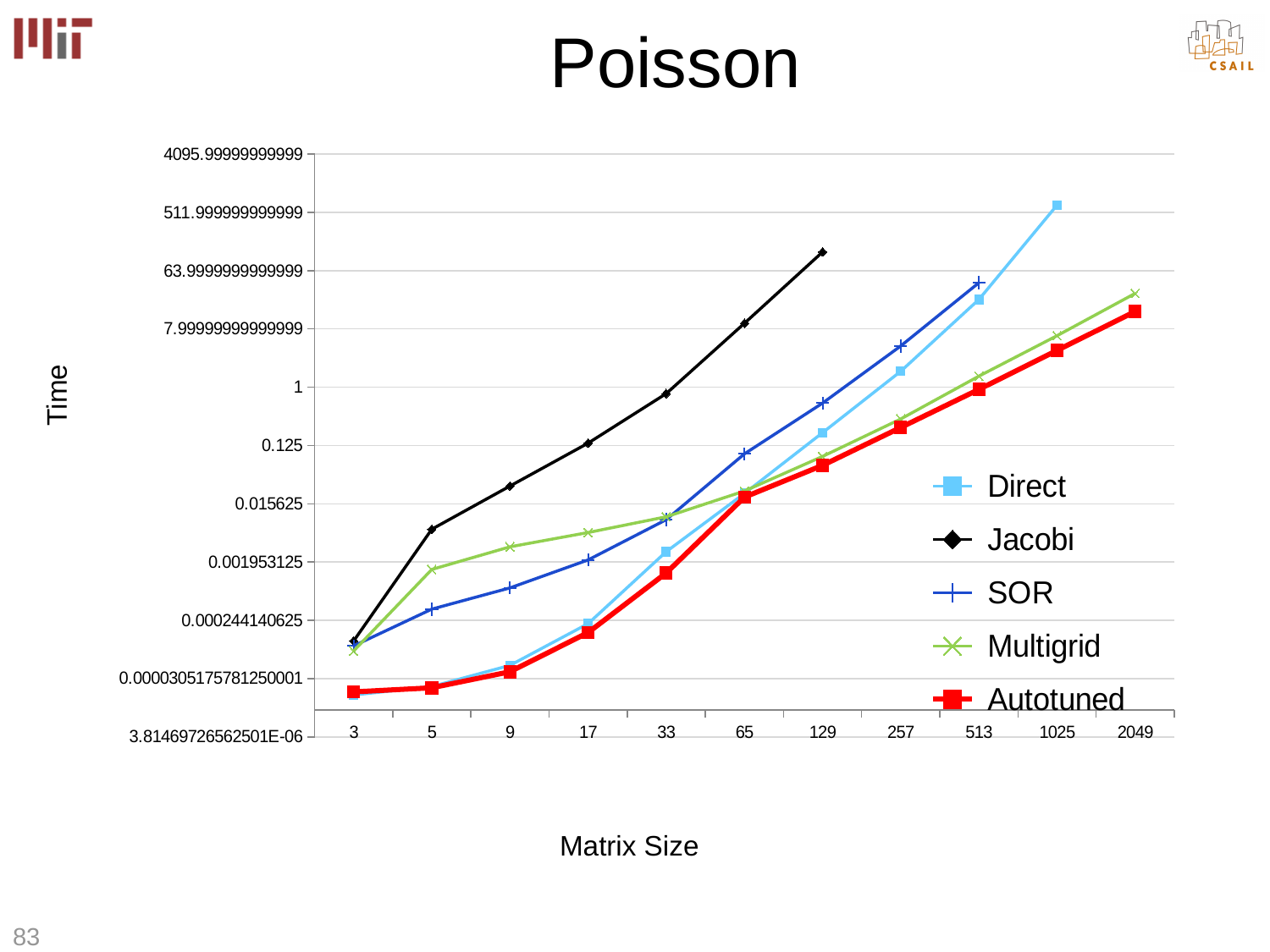
Does the Autotuned time rise or fall as matrix size increases? rise How many matrix sizes are shown on the x axis? 11 What kind of chart is shown on the slide? line chart What is the title of the chart? Poisson What is the label of the x axis? Matrix Size Which series has the highest time at matrix size 129? Jacobi At matrix size 5, which has the larger time, Jacobi or SOR? Jacobi Is the Jacobi time at matrix size 65 greater or less than 1? greater How many series does the legend list? 5 Is the Autotuned time at matrix size 257 greater or less than 1? less At matrix size 2049, which has the larger time, Multigrid or Autotuned? Multigrid Which series has the lowest time at matrix size 2049? Autotuned